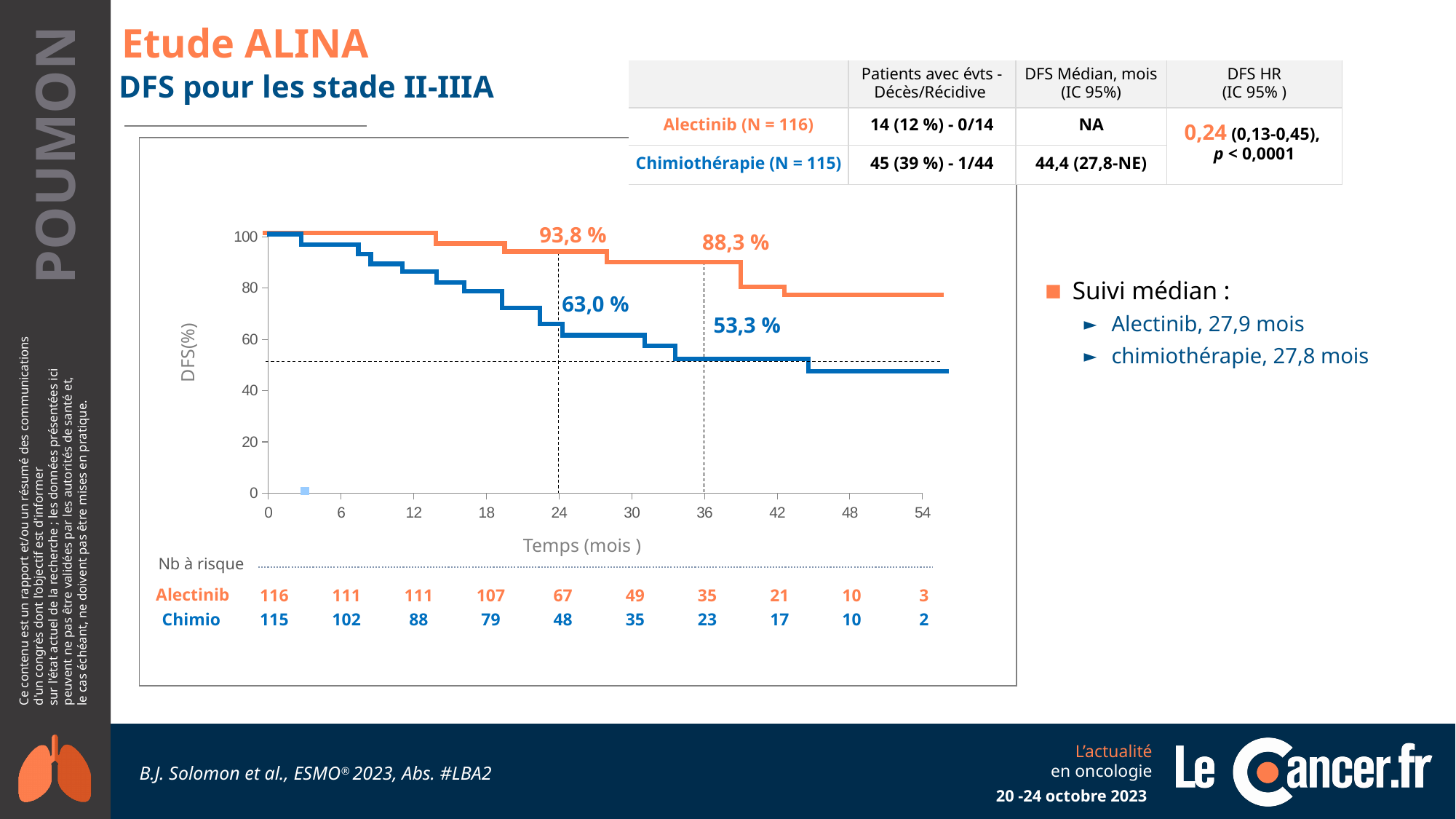
Is the DFS value for Alectinib at 48 months greater or less than 80? less Which arm has the higher DFS rate at 36 months, Alectinib or chemotherapy? Alectinib Do the DFS curves rise or fall as time increases along the x axis? fall What is the difference in DFS rate between Alectinib and chemotherapy at 36 months? 35,0 % What is the difference in DFS rate between Alectinib and chemotherapy at 24 months? 30,8 % What kind of chart is shown on the slide? line chart (Kaplan-Meier curve) How many patients are at risk in the Chimio arm at 36 months? 23 What is the DFS rate for Alectinib at 36 months? 88,3 % What is the DFS rate for Alectinib at 24 months? 93,8 % What is the DFS rate for the chemotherapy arm at 36 months? 53,3 % How many patients are at risk in the Alectinib arm at 24 months? 67 What is the DFS rate for the chemotherapy arm at 24 months? 63,0 %